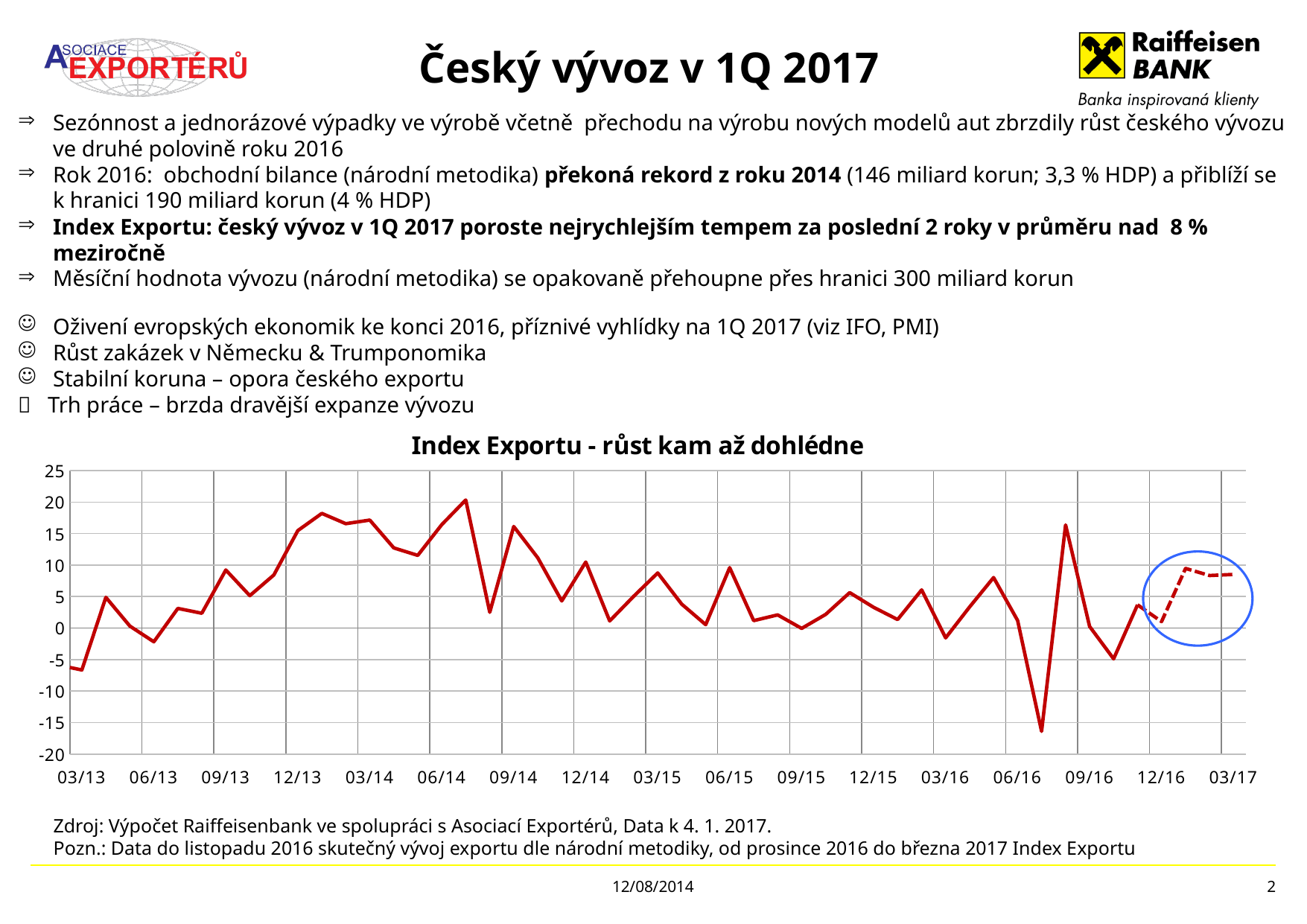
In which year does the line reach its highest value? 2014 Is the value at 12/13 greater or less than 10? greater How many labelled dates are shown on the x axis of the chart? 17 Does the line rise or fall between 12/16 and 03/17? rise In which year does the line reach its lowest value? 2016 Is the lowest point of the line greater or less than -10? less What is the title of the chart? Index Exportu - růst kam až dohlédne Is the value at 03/15 greater or less than 5? greater What kind of chart is shown on the slide? line chart